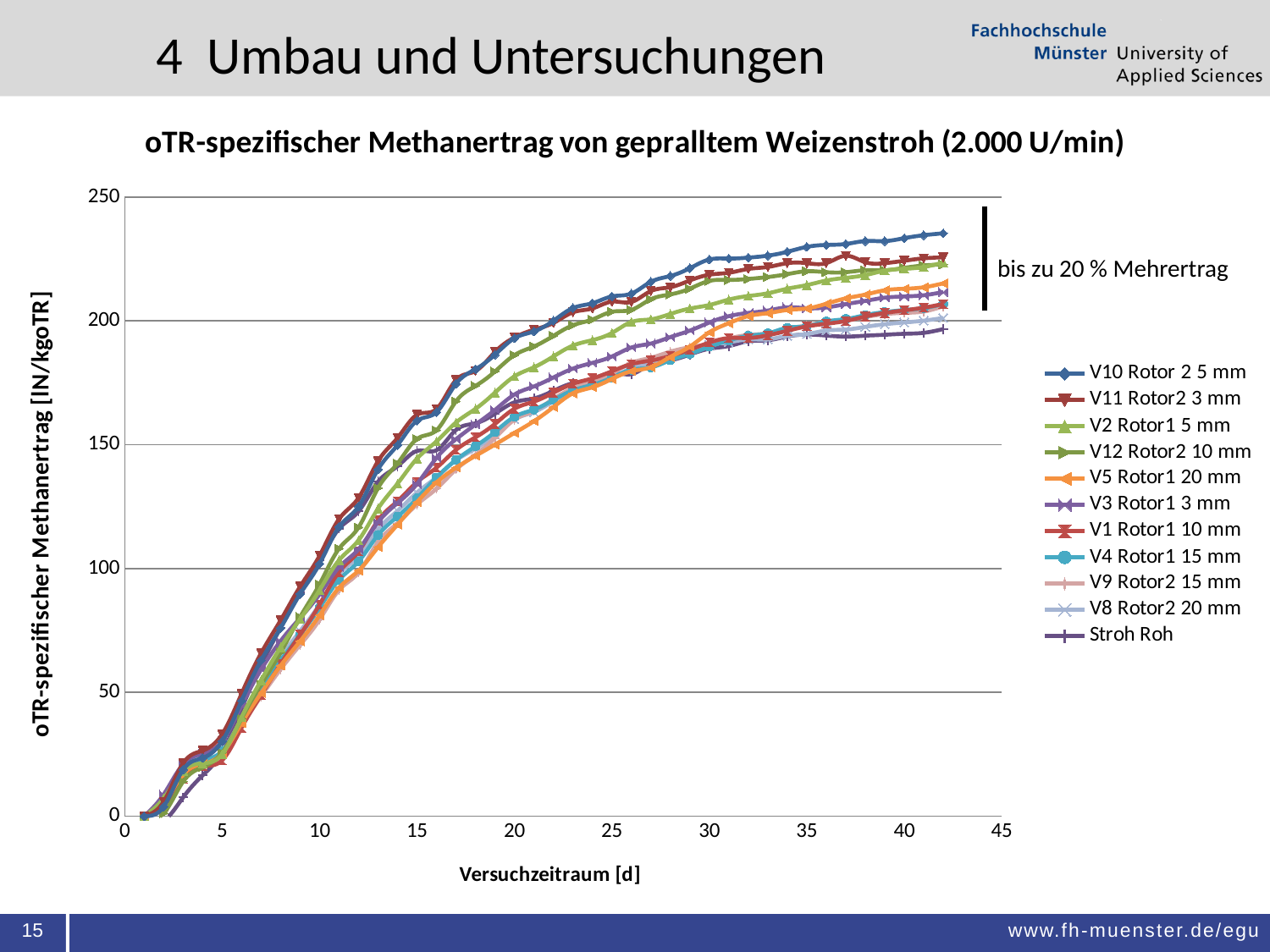
Is the value for V10 Rotor 2 5 mm at day 42 greater or less than 200? greater At day 42, which is larger: the value for V10 Rotor 2 5 mm or the value for Stroh Roh? V10 Rotor 2 5 mm Is the value for V11 Rotor2 3 mm at day 42 greater or less than 200? greater Is the value for V10 Rotor 2 5 mm at day 10 greater or less than 150? less What kind of chart is shown on the slide? line chart Which series has the highest value at the end of the test period (around day 42)? V10 Rotor 2 5 mm Do the values of the series rise or fall along the x axis? rise What is the title of the chart? oTR-spezifischer Methanertrag von gepralltem Weizenstroh (2.000 U/min) How many series does the legend list? 11 What text is written next to the vertical bar at the right of the plot area? bis zu 20 % Mehrertrag At day 42, which is larger: the value for V10 Rotor 2 5 mm or the value for V5 Rotor1 20 mm? V10 Rotor 2 5 mm